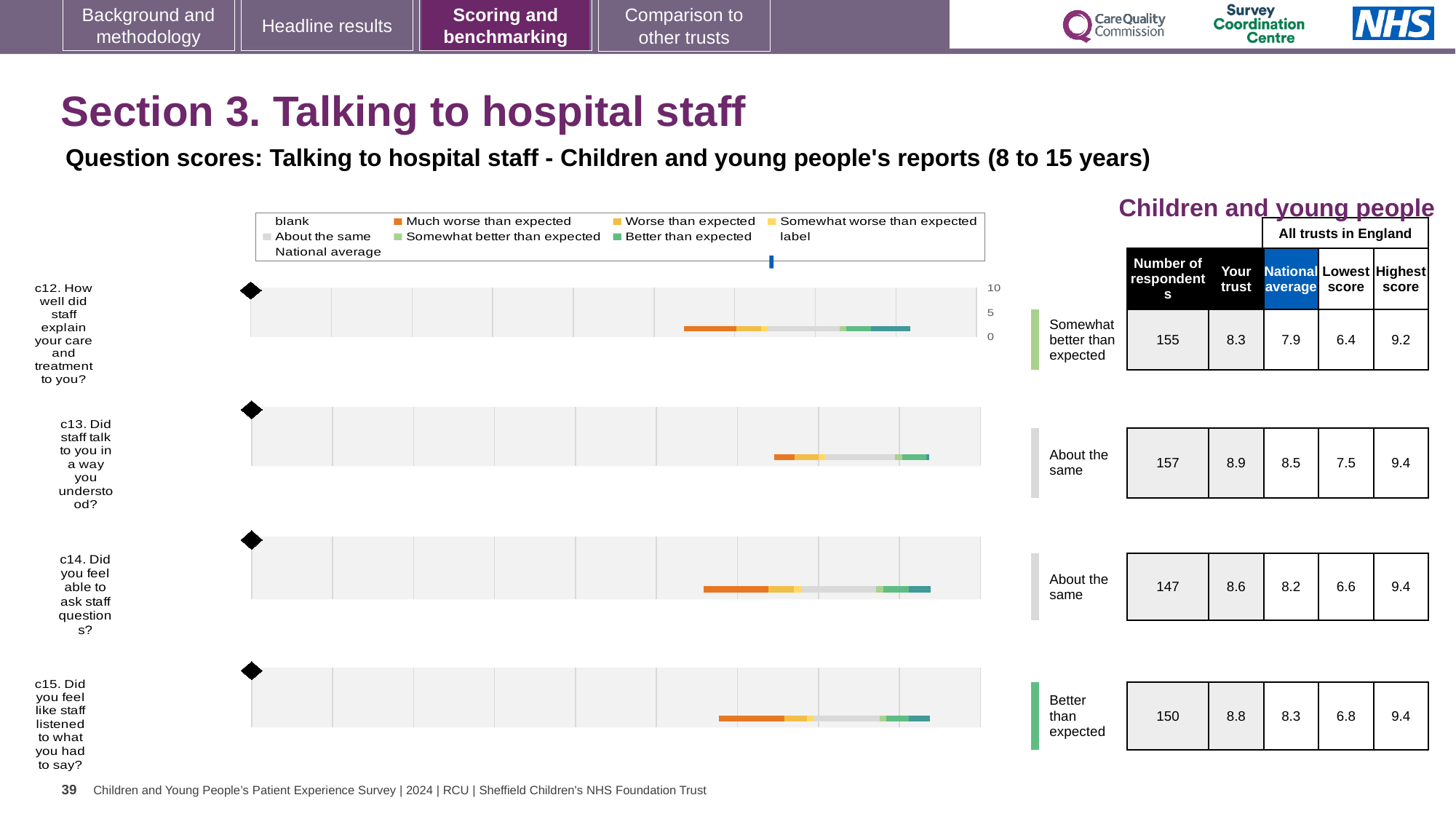
For c12, what is the difference between the 'Your trust' score and the national average? 0.4 For c12 (How well did staff explain your care and treatment to you?), what is the 'Your trust' score shown in the table? 8.3 In the chart legend, which colour represents 'Much worse than expected'? orange What kind of chart is used for each question row on the slide? bar chart For c13 (Did staff talk to you in a way you understood?), what is the national average score? 8.5 What is the highest score across all trusts in England for c15 (Did you feel like staff listened to what you had to say?)? 9.4 How many survey questions (charts) are plotted on the slide? 4 How many respondents are listed for c14 (Did you feel able to ask staff questions?)? 147 What benchmark category is shown for c15 (Did you feel like staff listened to what you had to say?)? Better than expected Which question has the highest 'Your trust' score? c13 For c14, which is larger: the 'Your trust' score or the national average? Your trust Which question has the lowest number of respondents? c14